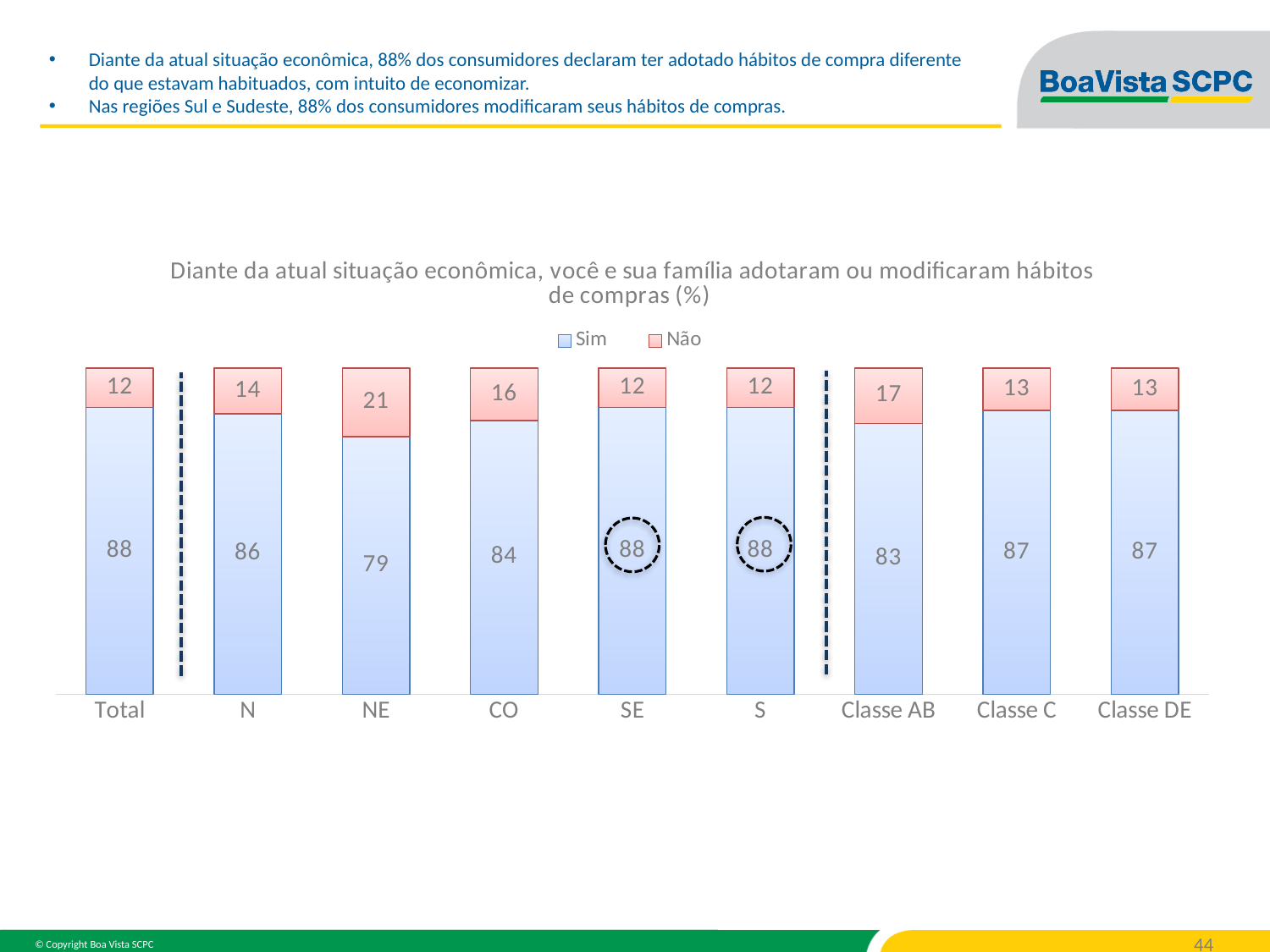
What kind of chart is shown on the slide? Stacked bar chart What is the value of "Sim" for CO? 84 What is the value of "Não" for Classe AB? 17 Which category has the lowest "Sim" value? NE How many series does the legend list? 2 Which category has the highest "Não" value? NE What is the difference between the "Sim" values for Total and NE? 9 What are the two series named in the legend? Sim and Não What is the value of "Sim" for NE? 79 What is the total of the stacked bar for Classe C? 100 Which is larger, the "Não" value for N or for CO? CO How many categories are shown on the x axis? 9